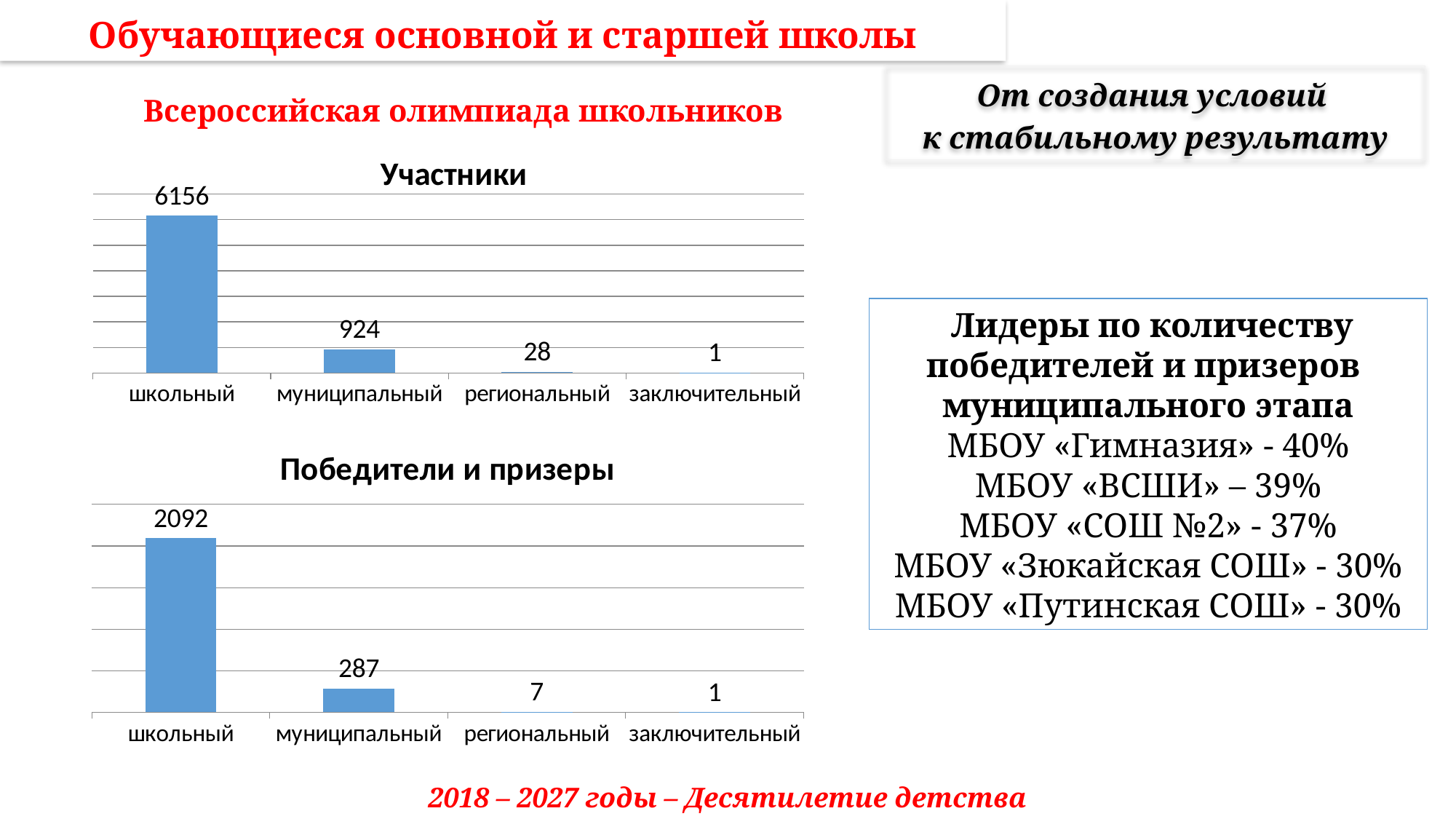
In the 'Победители и призеры' chart, what is the value for региональный? 7 What type of chart is the 'Победители и призеры' chart? bar chart In the 'Победители и призеры' chart, what is the difference between the values for муниципальный and региональный? 280 In the 'Победители и призеры' chart, what is the value for школьный? 2092 In the 'Участники' chart, what is the value for муниципальный? 924 In the 'Победители и призеры' chart, what is the value for муниципальный? 287 In the 'Участники' chart, what is the value for региональный? 28 In the 'Участники' chart, which category has the highest value? школьный In the 'Участники' chart, what is the value for школьный? 6156 In the 'Победители и призеры' chart, which category has the lowest value? заключительный How many categories are shown in the 'Участники' chart? 4 In the 'Участники' chart, what is the difference between the values for школьный and муниципальный? 5232